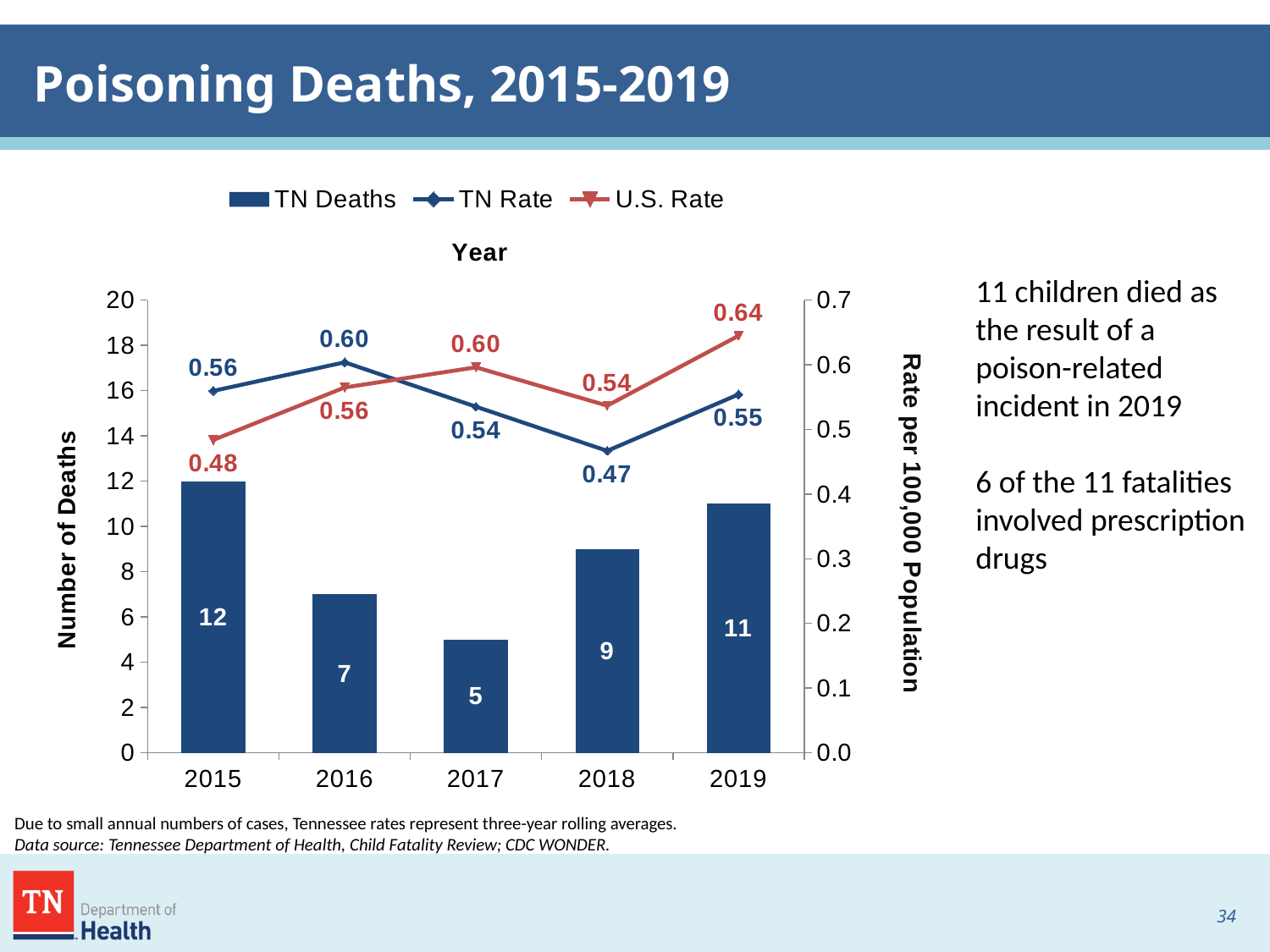
Which year had the highest number of TN Deaths? 2015 Which year had the lowest U.S. Rate? 2015 Which was larger in 2019, the TN Rate or the U.S. Rate? U.S. Rate How many TN Deaths were there in 2017? 5 What is the label of the right-hand y axis? Rate per 100,000 Population How many series does the legend list? 3 What is the difference in TN Deaths between 2015 and 2016? 5 What was the TN Rate in 2018? 0.47 What kind of chart is used to show TN Deaths? Bar chart How many years are shown on the x axis? 5 Does the U.S. Rate rise or fall from 2018 to 2019? Rise What was the U.S. Rate in 2019? 0.64